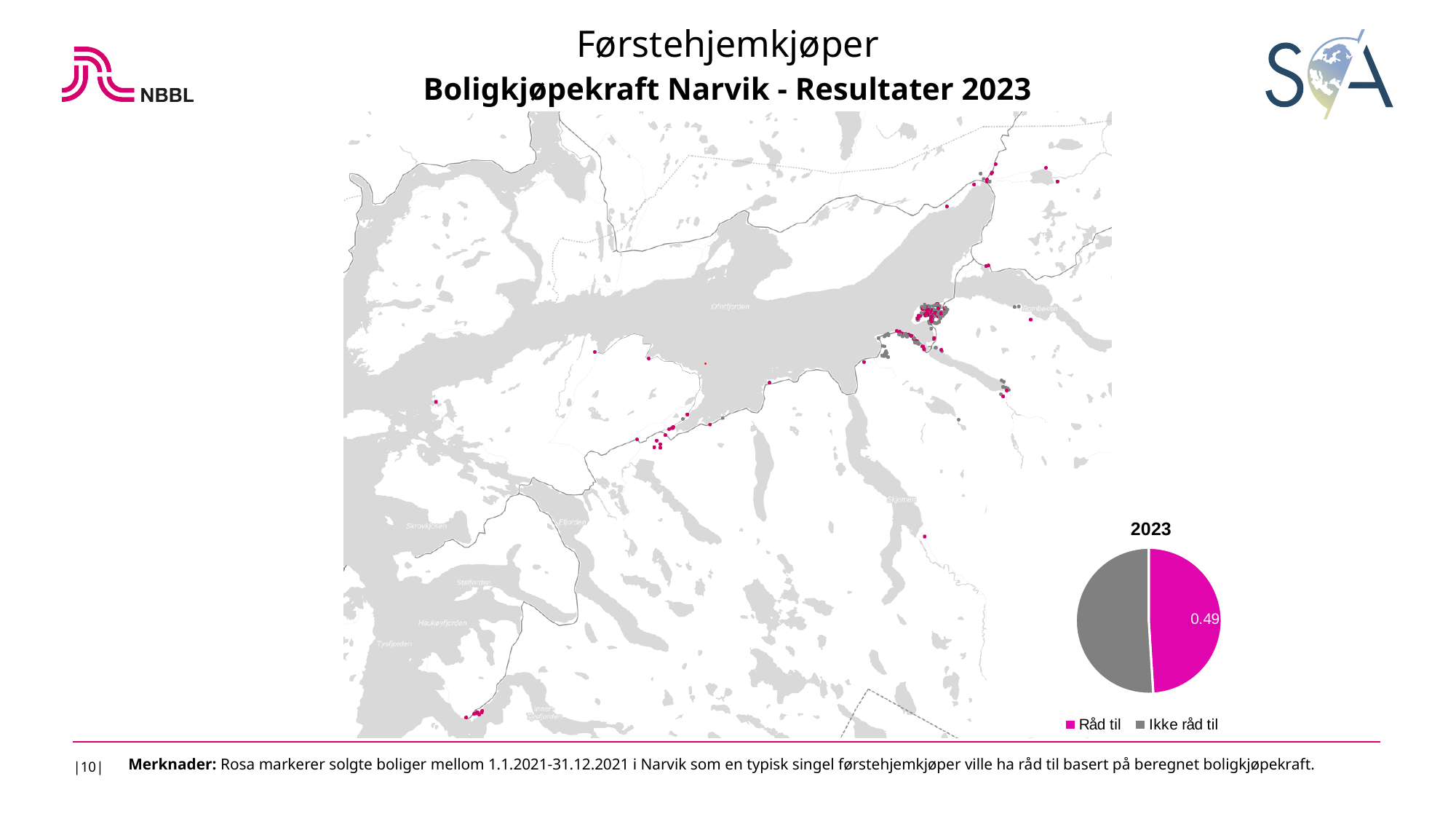
In the pie chart, what value is shown for the 'Råd til' slice? 0.49 What is the title shown above the pie chart? 2023 Which legend entries are listed for the pie chart? Råd til, Ikke råd til How many slices does the pie chart have? 2 What kind of chart is shown in the bottom right of the slide? Pie chart In the pie chart, is the share for 'Råd til' greater or less than 0.5? less In the pie chart, which slice is larger, 'Råd til' or 'Ikke råd til'? Ikke råd til How many entries does the pie chart's legend list? 2